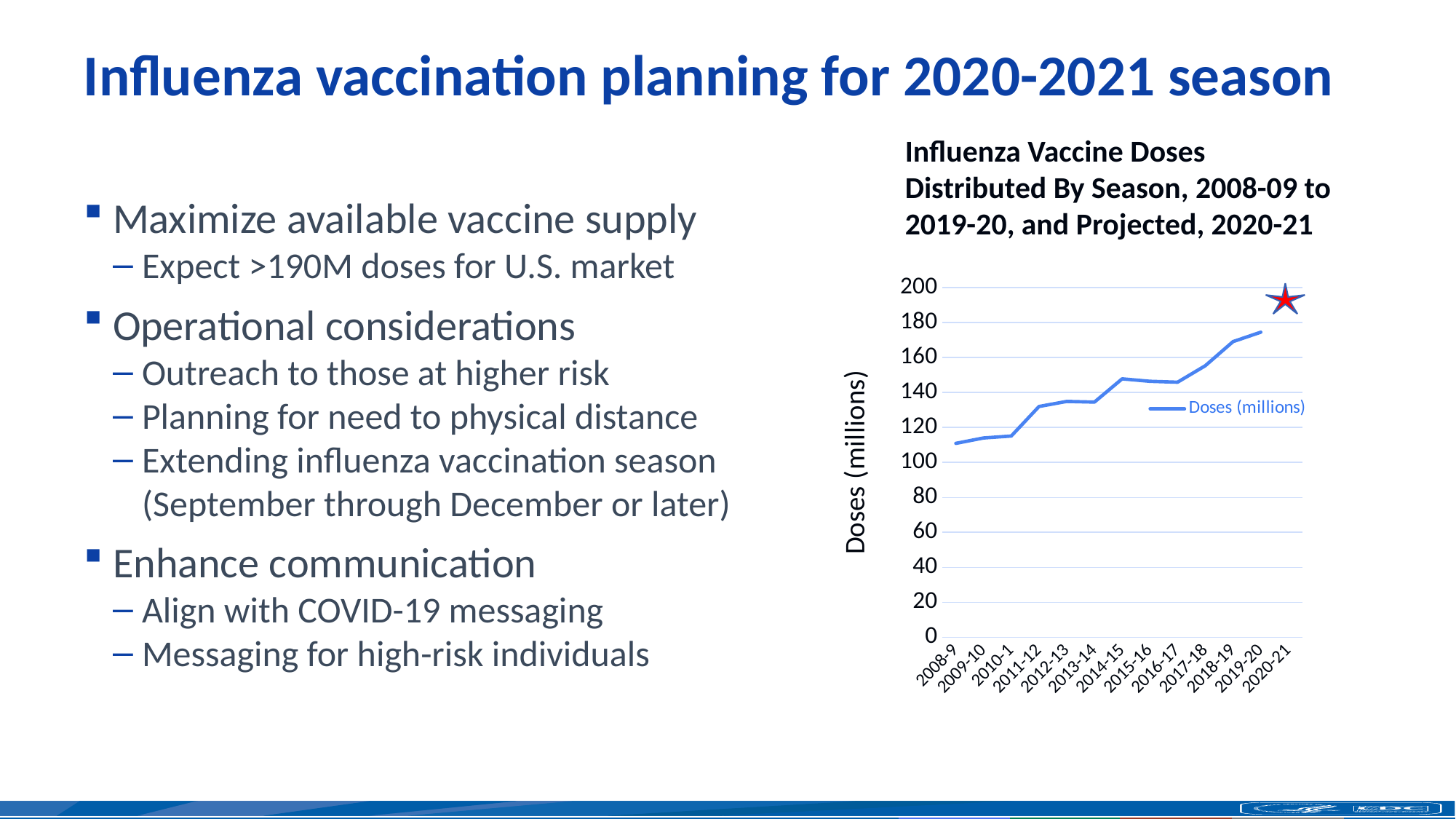
Do the values in the chart generally rise or fall from 2008-9 to 2020-21? rise Is the value for 2008-9 greater or less than 120? less Which season has the larger value, 2014-15 or 2010-1? 2014-15 What is the label on the chart's vertical axis? Doses (millions) Is the value for 2011-12 greater or less than 120? greater What kind of chart is shown on the slide? line chart How many seasons are plotted along the x axis of the chart? 13 Which season has the highest value in the chart? 2019-20 What is the title of the chart? Influenza Vaccine Doses Distributed By Season, 2008-09 to 2019-20, and Projected, 2020-21 Is the value for 2018-19 greater or less than 160? greater How many series does the chart's legend list? 1 Which season has the lowest number of doses distributed in the chart? 2008-9